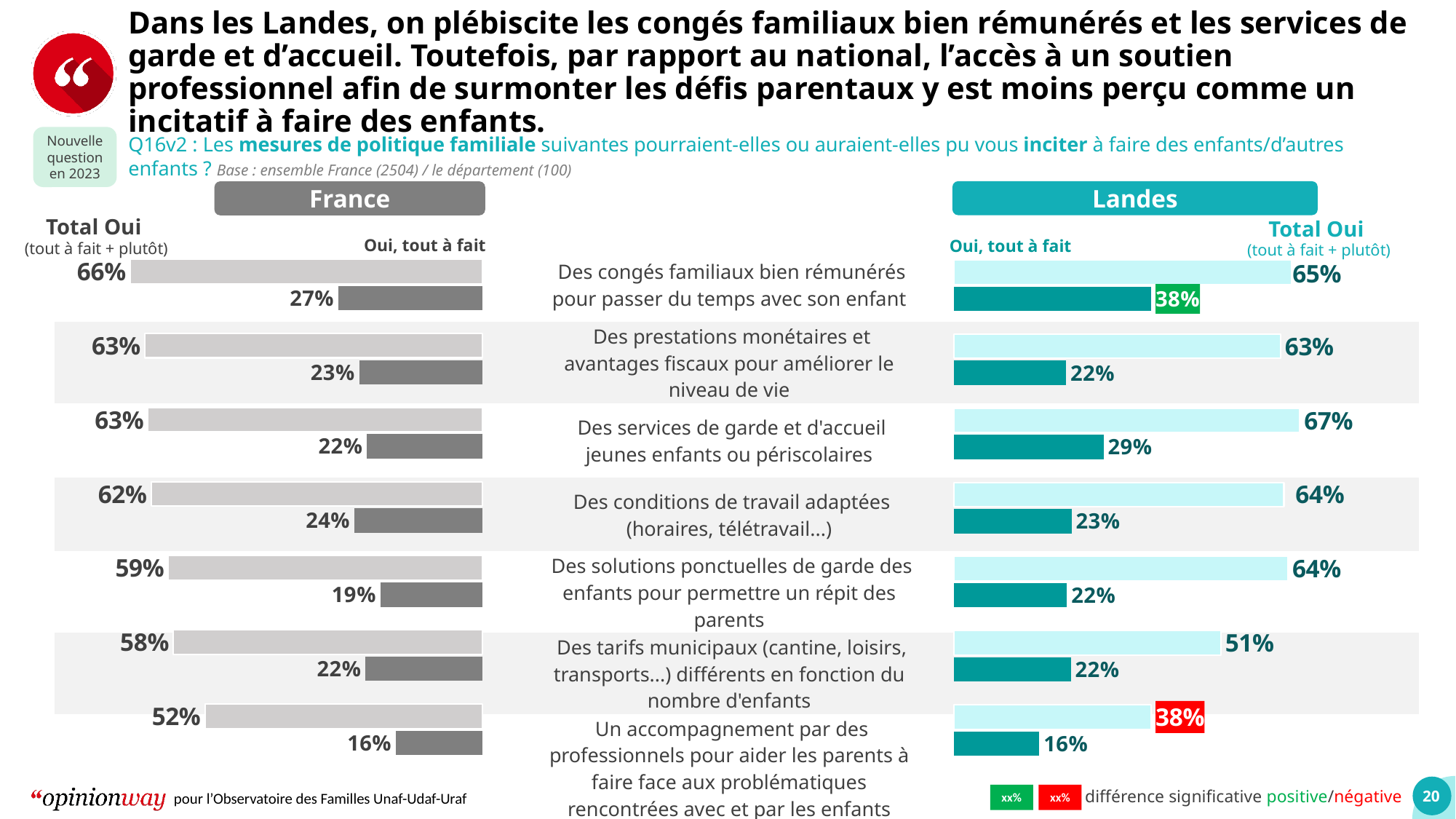
In the Landes chart, which measure has the lowest 'Oui, tout à fait' value? Un accompagnement par des professionnels pour aider les parents à faire face aux problématiques rencontrées avec et par les enfants (16%) In the France chart, which measure has the lowest Total Oui value? Un accompagnement par des professionnels pour aider les parents à faire face aux problématiques rencontrées avec et par les enfants (52%) In the France chart, what is the difference between Total Oui and 'Oui, tout à fait' for 'Des congés familiaux bien rémunérés pour passer du temps avec son enfant'? 39 points In the France chart, what is the Total Oui value for 'Des congés familiaux bien rémunérés pour passer du temps avec son enfant'? 66% What type of chart is used on this slide? Bar chart In the France chart, what is the 'Oui, tout à fait' value for 'Des tarifs municipaux (cantine, loisirs, transports…) différents en fonction du nombre d'enfants'? 22% What is the difference in Total Oui for 'Un accompagnement par des professionnels…' between the France chart (52%) and the Landes chart (38%)? 14 points In the Landes chart, which has the higher 'Oui, tout à fait' value: 'Des services de garde et d'accueil jeunes enfants ou périscolaires' or 'Des conditions de travail adaptées (horaires, télétravail…)'? Des services de garde et d'accueil jeunes enfants ou périscolaires In the Landes chart, what is the 'Oui, tout à fait' value for 'Des congés familiaux bien rémunérés pour passer du temps avec son enfant'? 38% How many family policy measures are listed in the charts? 7 In the Landes chart, which measure has the highest Total Oui value? Des services de garde et d'accueil jeunes enfants ou périscolaires (67%) How many series does each chart show? 2 (Total Oui and Oui, tout à fait)